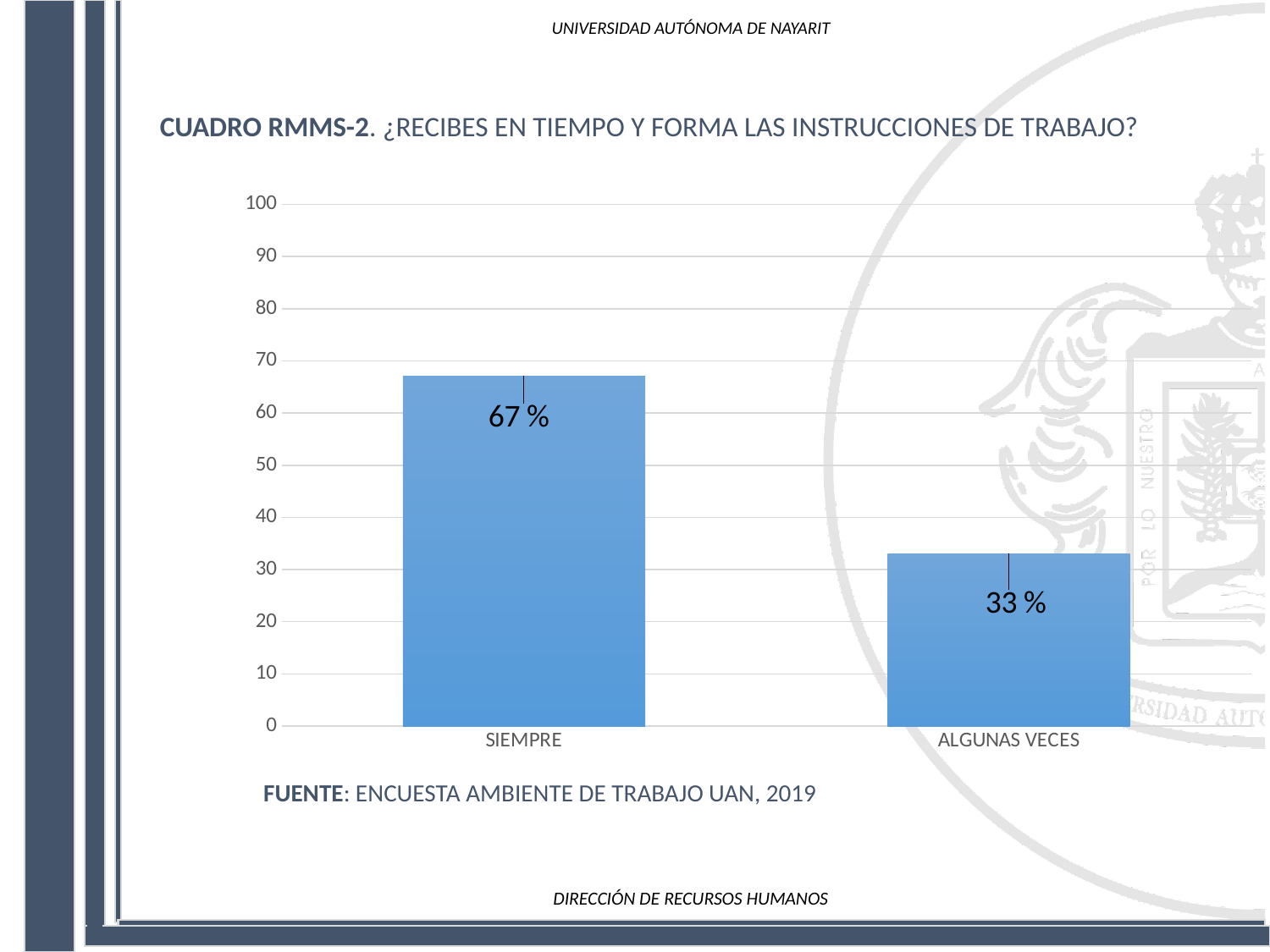
What is the value for SIEMPRE? 67 % Which category has the lowest value? ALGUNAS VECES Is the value for SIEMPRE greater or less than 60? greater Is the value for ALGUNAS VECES greater or less than 40? less What is the title of the chart? CUADRO RMMS-2. ¿RECIBES EN TIEMPO Y FORMA LAS INSTRUCCIONES DE TRABAJO? What is the value for ALGUNAS VECES? 33 % What is the source cited below the chart? ENCUESTA AMBIENTE DE TRABAJO UAN, 2019 What is the difference between the values for SIEMPRE and ALGUNAS VECES? 34 % Which is larger, the value for SIEMPRE or the value for ALGUNAS VECES? SIEMPRE What kind of chart is shown on the slide? bar chart How many categories are shown in the chart? 2 Which category has the highest value? SIEMPRE